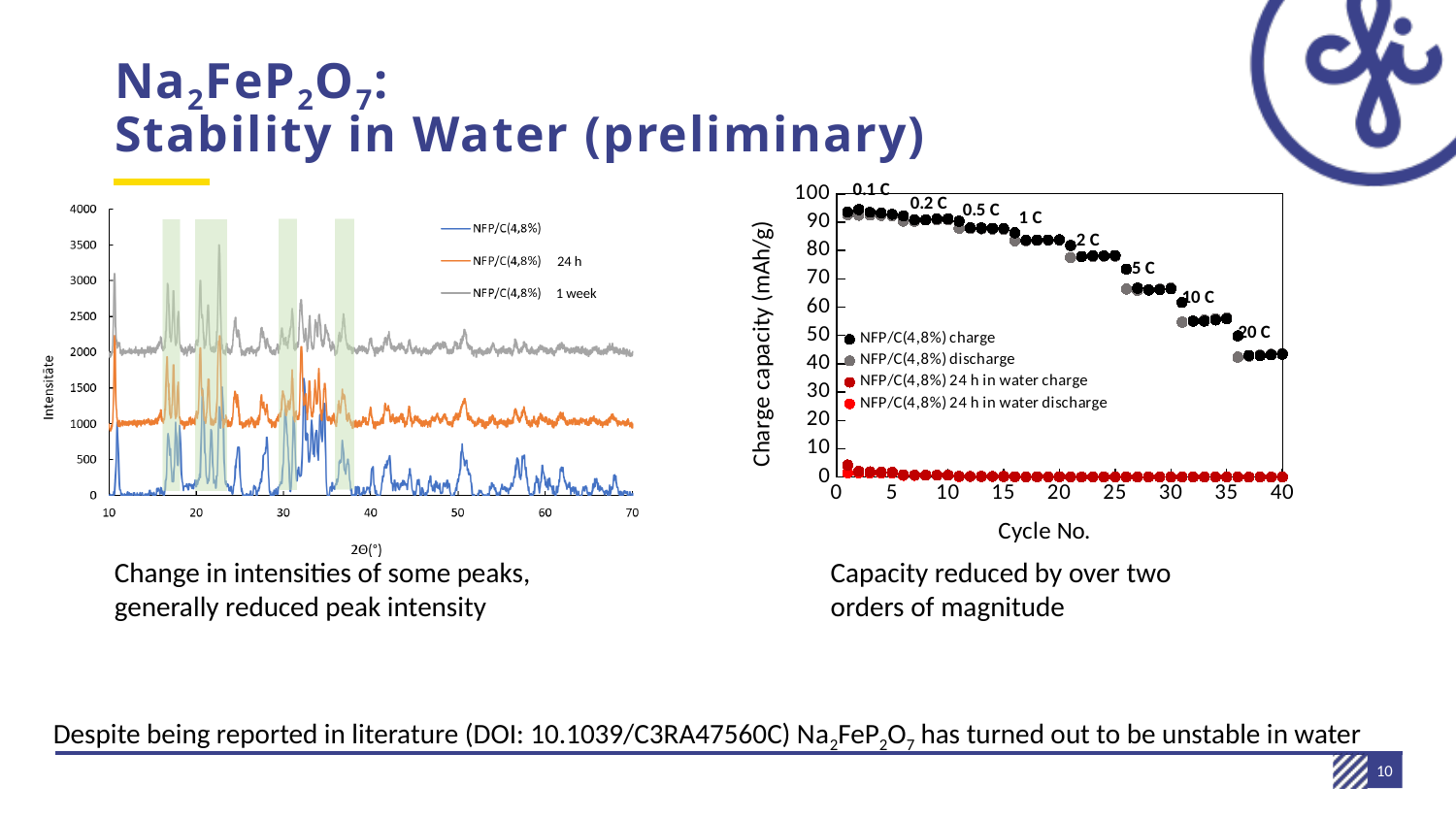
What kind of chart is the right chart (Charge capacity vs Cycle No.)? scatter chart How many C-rate labels (0.1 C, 0.2 C, ...) are annotated on the right chart? 8 How many series does the legend of the right chart list? 4 In the right chart, is the NFP/C(4,8%) charge capacity at cycle 1 greater or less than 90 mAh/g? greater In the right chart, is the NFP/C(4,8%) 24 h in water charge capacity at cycle 20 greater or less than 10 mAh/g? less What is the y-axis label of the right chart? Charge capacity (mAh/g) In the right chart, does the NFP/C(4,8%) charge capacity rise or fall as the cycle number increases? fall In the right chart, is the NFP/C(4,8%) charge capacity at cycle 40 greater or less than 50 mAh/g? less What kind of chart is the left chart (Intensität vs 2Θ)? line chart How many series does the legend of the left chart list? 3 In the right chart, at cycle 20, which series has the larger value: NFP/C(4,8%) charge or NFP/C(4,8%) 24 h in water charge? NFP/C(4,8%) charge